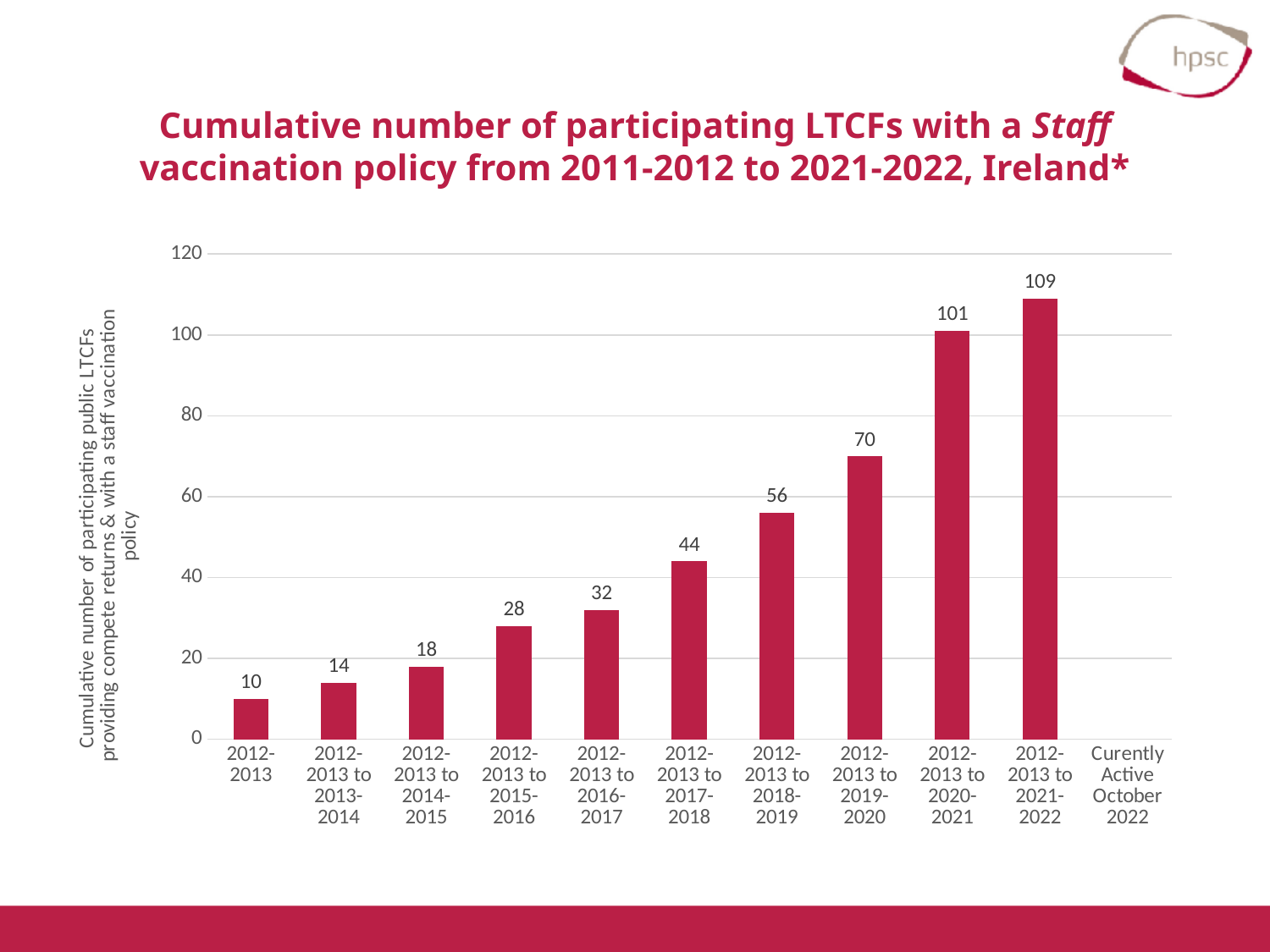
Which category has the highest value? 2012-2013 to 2021-2022 What is the difference between the values for 2012-2013 to 2018-2019 and 2012-2013 to 2016-2017? 24 What is the value for the 2012-2013 to 2014-2015 bar? 18 What kind of chart is shown on the slide? bar chart Is the value for 2012-2013 to 2020-2021 greater or less than 100? greater What is the value for the 2012-2013 to 2021-2022 bar? 109 Do the values rise or fall from left to right along the x axis? rise Which category has the lowest value? 2012-2013 What is the difference between the values for 2012-2013 to 2020-2021 and 2012-2013 to 2019-2020? 31 What is the value for the 2012-2013 to 2017-2018 bar? 44 How many bars are plotted in the chart? 10 Which is larger, the value for 2012-2013 to 2015-2016 or the value for 2012-2013 to 2013-2014? 2012-2013 to 2015-2016